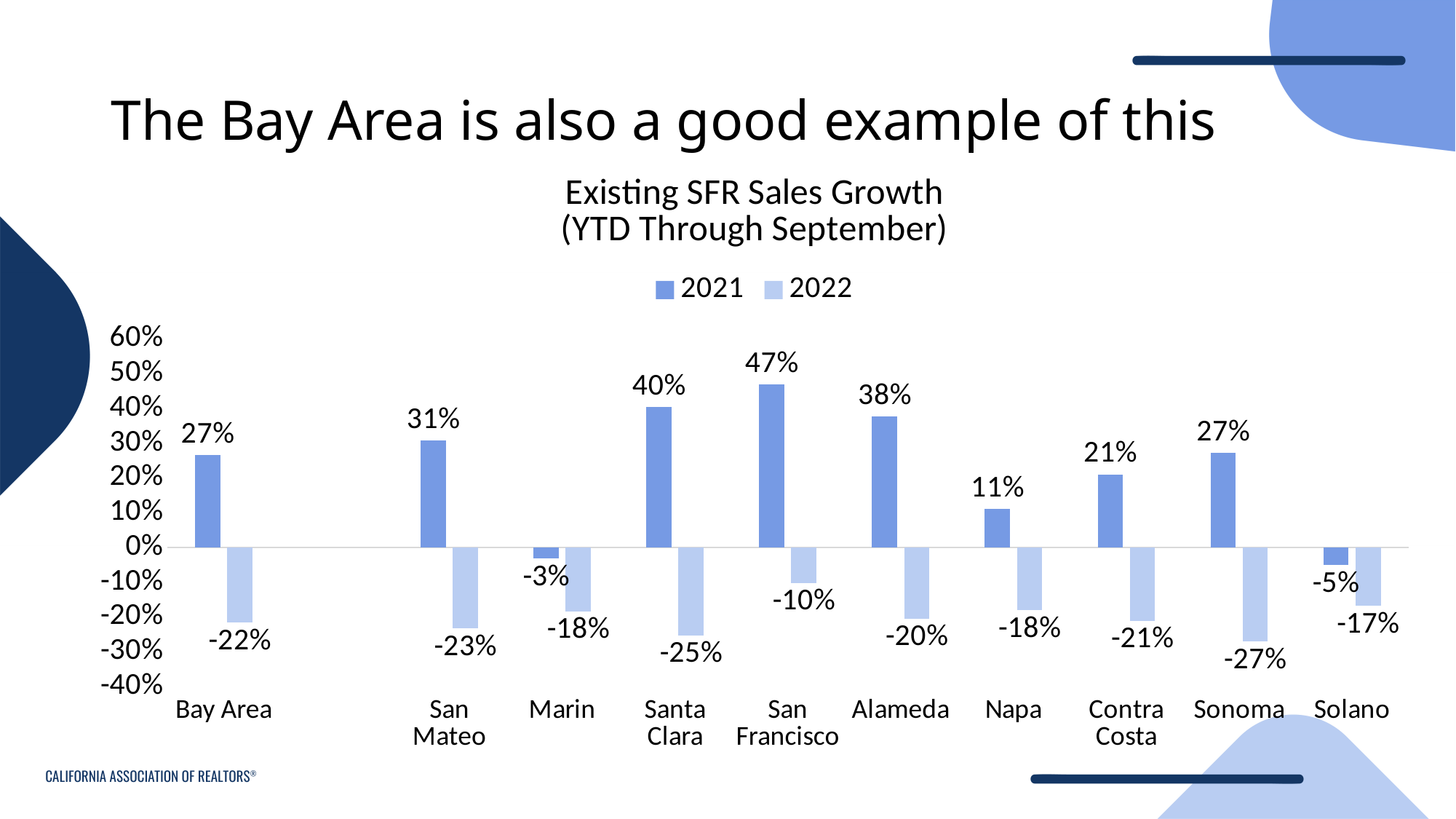
What is the 2022 value for Santa Clara? -25% Which category has the lowest 2021 value? Solano What is the difference between the 2021 and 2022 values for San Mateo? 54 percentage points How many categories are labeled on the x axis? 10 Which is larger, the 2021 value for Alameda or the 2021 value for Santa Clara? Santa Clara What is the 2021 value for San Francisco? 47% Which category has the highest 2021 value? San Francisco What kind of chart is shown on the slide? Bar chart Which category has the lowest 2022 value? Sonoma What is the 2021 value for Marin? -3% How many series does the legend list? 2 What is the 2022 value for Solano? -17%